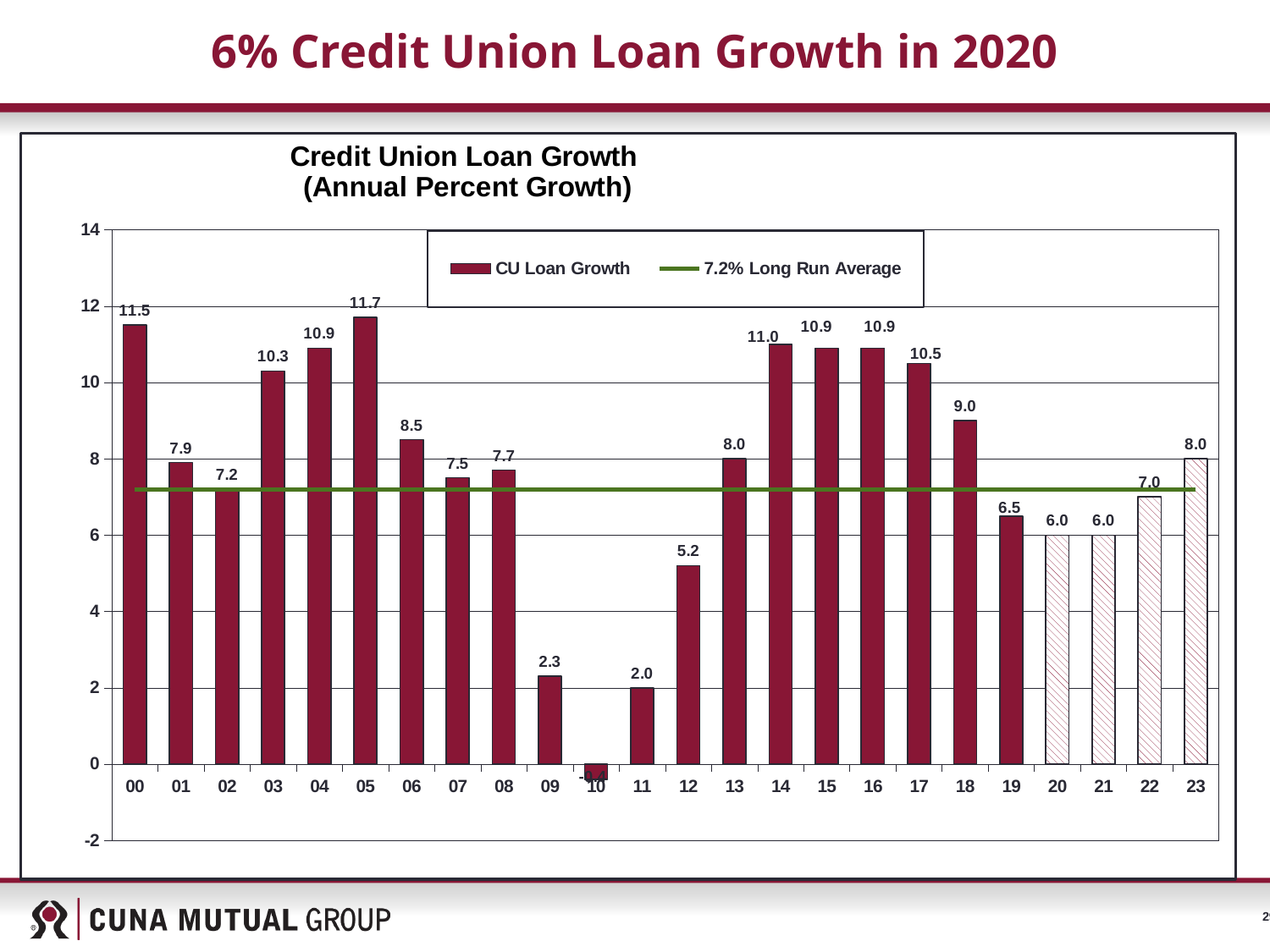
How many series does the legend list? 2 What is the CU loan growth value for 23? 8.0 What is the CU loan growth value for 12? 5.2 How many years are shown on the x axis? 24 What kind of chart is this? combination bar and line chart What is the CU loan growth value for 05? 11.7 What is the difference between the CU loan growth values for 00 and 01? 3.6 Which is larger, the CU loan growth value for 14 or for 18? 14 Is the CU loan growth value for 09 greater or less than 4? less Do the CU loan growth values rise or fall from 16 to 19? fall Which year has the highest CU loan growth? 05 Which year has the lowest CU loan growth? 10